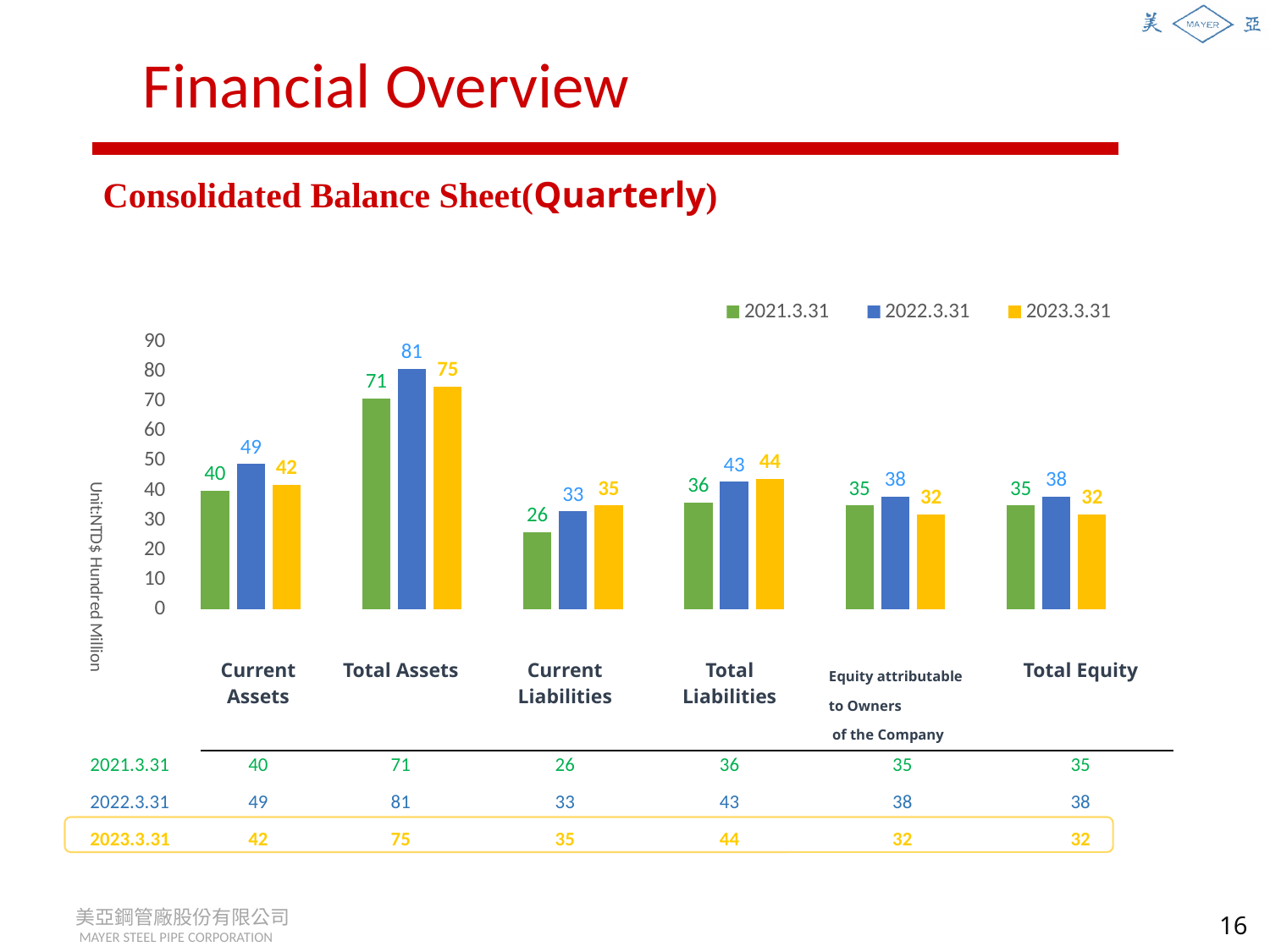
What is the value for Current Liabilities in the 2021.3.31 series? 26 What is the difference between the 2022.3.31 and 2021.3.31 values for Total Assets? 10 Which category has the lowest value in the 2021.3.31 series? Current Liabilities Which category has the highest value in the 2023.3.31 series? Total Assets What unit is given on the vertical axis label of the chart? NTD$ Hundred Million What is the value for Total Equity in the 2023.3.31 series? 32 What kind of chart is shown on the slide? bar chart Which is larger for Current Assets: the 2022.3.31 value or the 2023.3.31 value? 2022.3.31 How many categories are shown on the x axis of the chart? 6 What is the value for Total Assets in the 2022.3.31 series? 81 How many series does the legend list? 3 Is the value for Total Liabilities in the 2023.3.31 series greater or less than 40? greater